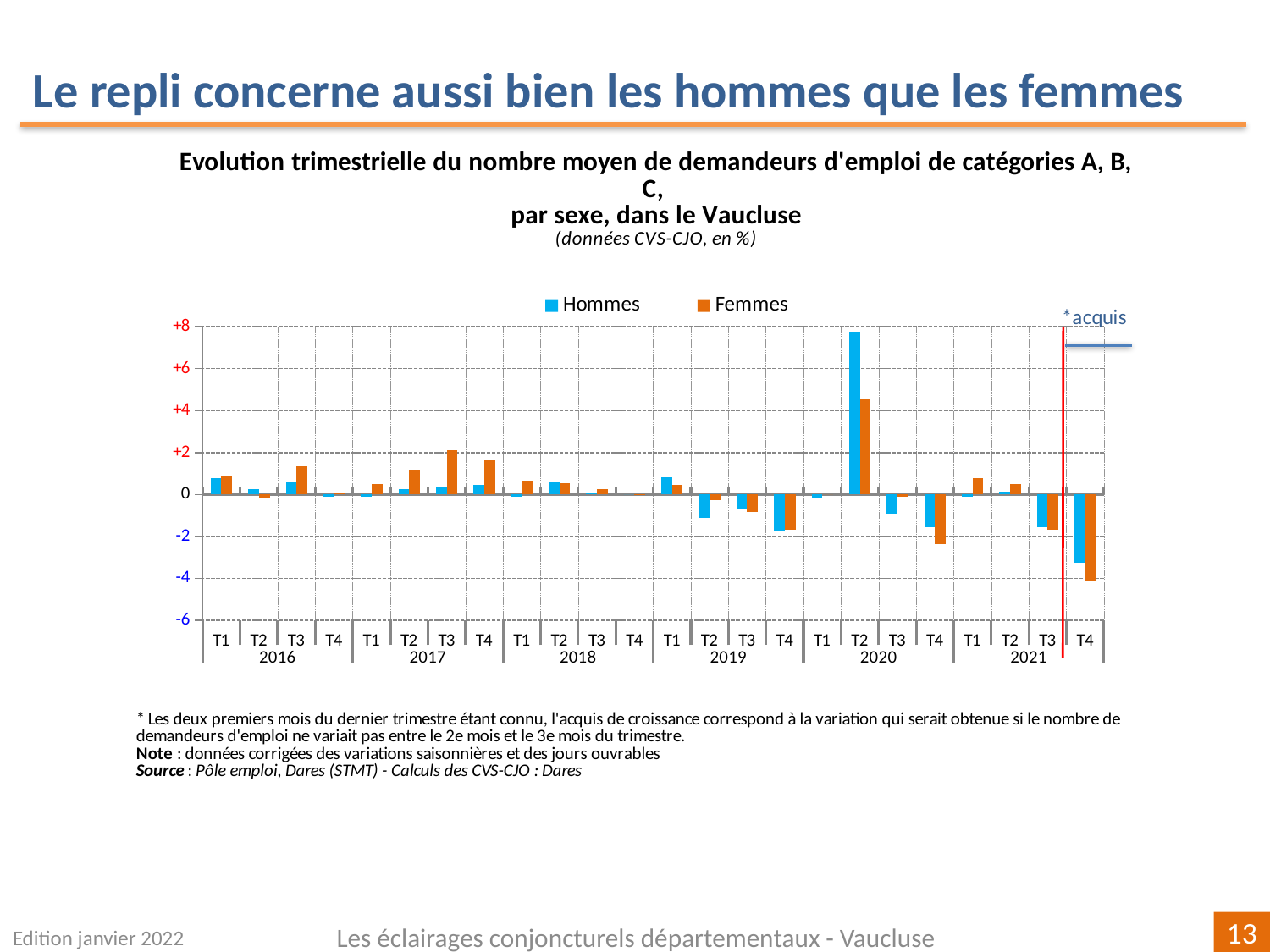
Is the Femmes value for T2 2020 greater or less than +4? greater What kind of chart is shown on the slide? bar chart In which quarter is the Femmes value highest? T2 2020 In T3 2017, which series has the larger value, Hommes or Femmes? Femmes In which quarter is the Hommes value lowest? T4 2021 In which quarter is the Femmes value lowest? T4 2021 How many quarters are plotted on the x axis? 24 What are the two series named in the legend? Hommes and Femmes Is the Hommes value for T2 2020 greater or less than +6? greater Is the Hommes value for T4 2021 greater or less than -2? less In which quarter is the Hommes value highest? T2 2020 How many series does the legend list? 2